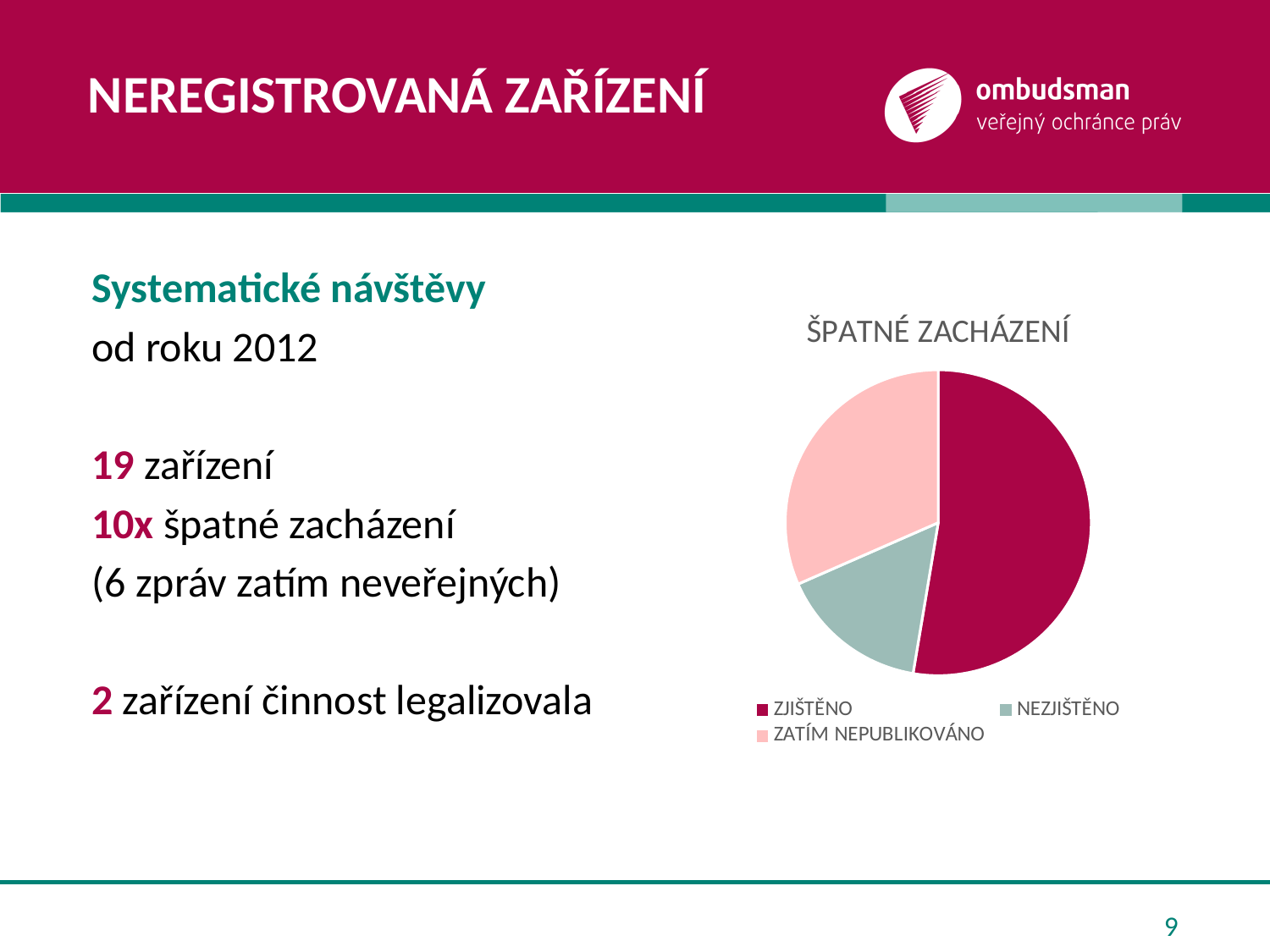
How many slices does the pie chart have? 3 Which slice of the pie chart is the largest? ZJIŠTĚNO What is the title of the pie chart? ŠPATNÉ ZACHÁZENÍ How many entries does the legend of the pie chart list? 3 Which slice is larger in the pie chart, ZJIŠTĚNO or ZATÍM NEPUBLIKOVÁNO? ZJIŠTĚNO Which slice is larger in the pie chart, ZATÍM NEPUBLIKOVÁNO or NEZJIŠTĚNO? ZATÍM NEPUBLIKOVÁNO Which legend entry of the pie chart is shown in dark red? ZJIŠTĚNO What kind of chart is shown on the slide? pie chart Which slice of the pie chart is the smallest? NEZJIŠTĚNO Which slice is larger in the pie chart, ZJIŠTĚNO or NEZJIŠTĚNO? ZJIŠTĚNO